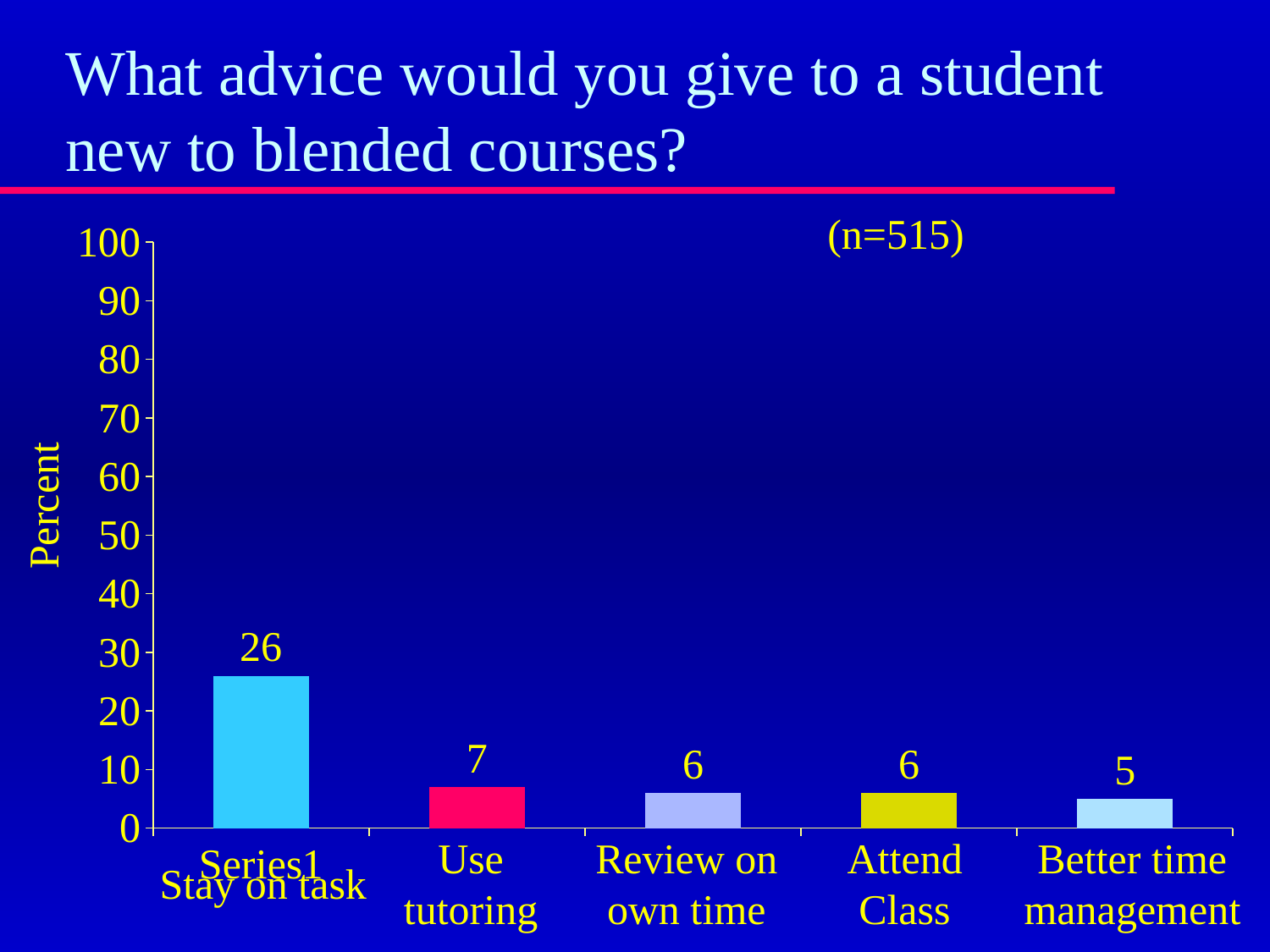
Which category has the lowest value? Better time management Which is larger, the value for Use tutoring or the value for Better time management? Use tutoring What kind of chart is shown on the slide? bar chart What is the label on the vertical axis of the chart? Percent Which category has the highest value? Stay on task Is the value for Stay on task greater or less than 20? greater What is the value for Attend Class? 6 What is the difference between the values for Stay on task and Use tutoring? 19 What is the value for Use tutoring? 7 What is the value for Better time management? 5 What is the value for Stay on task? 26 How many categories are shown on the chart? 5